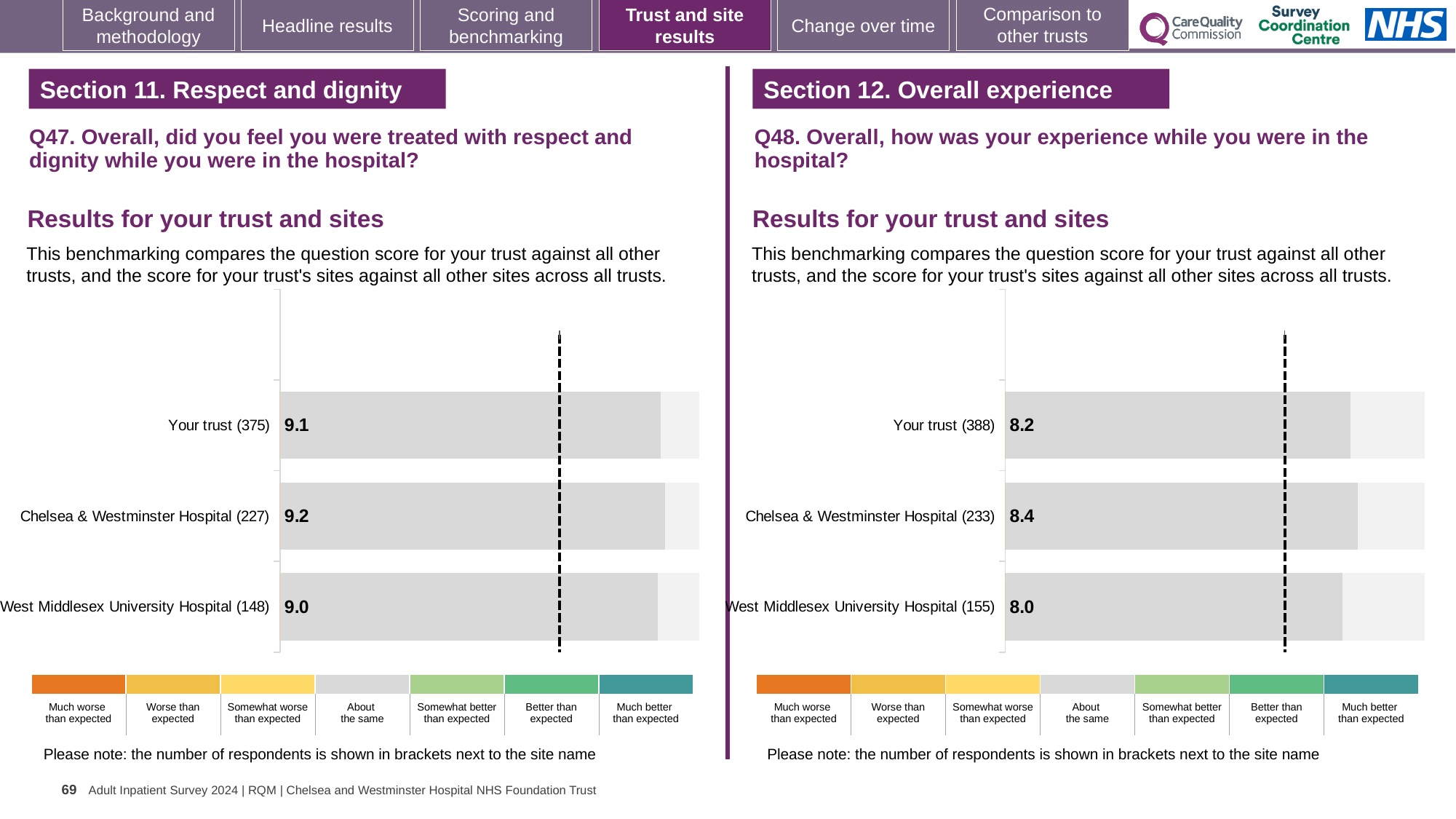
On the Q48 chart (right), how many respondents are shown for Chelsea & Westminster Hospital? 233 On the Q47 chart (left), what is the difference between the scores for Chelsea & Westminster Hospital and West Middlesex University Hospital? 0.2 On the Q48 chart (right), which site or trust has the highest score? Chelsea & Westminster Hospital On the Q47 chart (left), how many respondents are shown for Your trust? 375 What type of chart is used for the Q47 results (left)? Bar chart On the Q48 chart (right), is the score for Your trust higher or lower than the score for Chelsea & Westminster Hospital? lower How many bars are plotted on the Q48 chart (right)? 3 On the Q47 chart (left), what is the score for Your trust? 9.1 On the Q47 chart (left), which site or trust has the lowest score? West Middlesex University Hospital On the Q47 chart (left), what is the score for Chelsea & Westminster Hospital? 9.2 On the Q48 chart (right), what is the difference between the scores for Chelsea & Westminster Hospital and Your trust? 0.2 On the Q48 chart (right), what is the score for West Middlesex University Hospital? 8.0